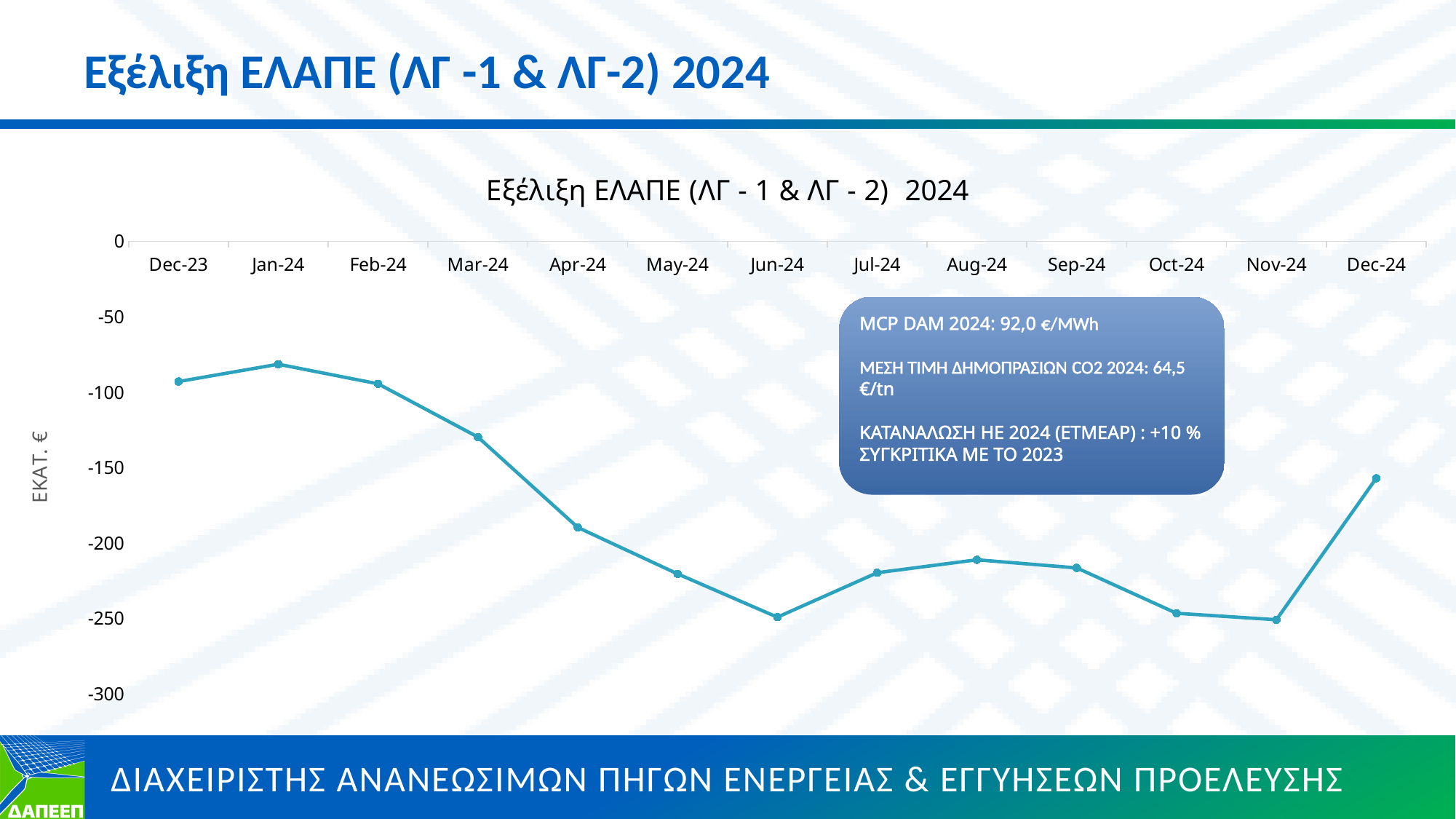
Do the values rise or fall from Jan-24 to Jun-24? fall What kind of chart is shown on the slide? line chart Is the value for Dec-24 greater or less than -200? greater Is the value for Jun-24 greater or less than -200? less Which has the larger value, Jan-24 or Apr-24? Jan-24 How many data points (months) are plotted on the chart? 13 Which has the larger value, Nov-24 or Dec-24? Dec-24 Is the value for Jan-24 greater or less than -100? greater Which month has the highest (least negative) value on the chart? Jan-24 What is the label on the vertical axis of the chart? ΕΚΑΤ. €